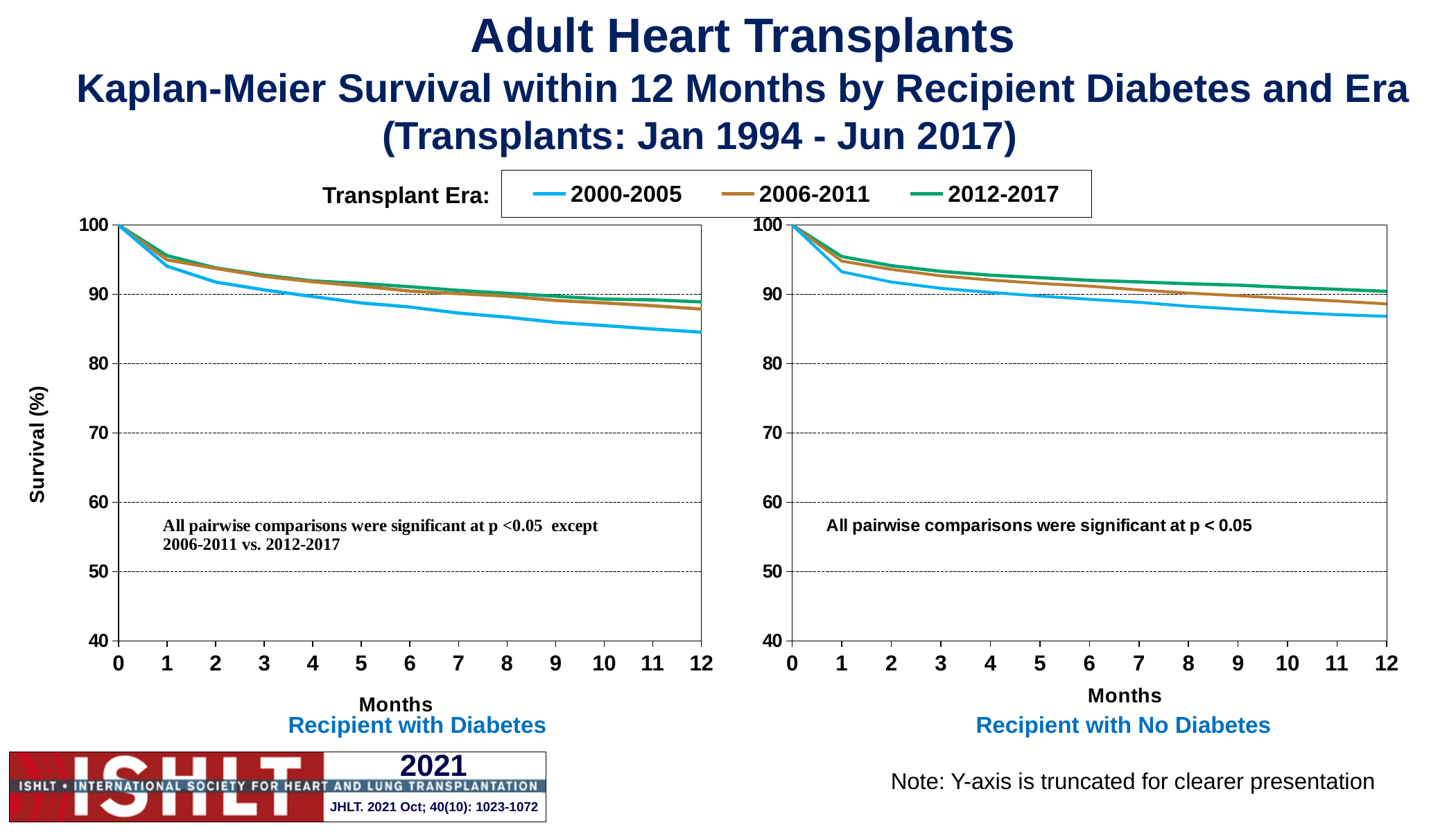
In the Recipient with Diabetes chart, is the survival for 2000-2005 at 12 months greater or less than 80? greater What type of chart is used on the slide for the Recipient with Diabetes panel? line chart What is the label of the y-axis on the slide? Survival (%) In the Recipient with Diabetes chart, is the survival for 2000-2005 at 12 months greater or less than 90? less In the Recipient with No Diabetes chart, which transplant era has the lowest survival at 12 months? 2000-2005 In the Recipient with No Diabetes chart, at 12 months is survival for 2012-2017 higher or lower than for 2000-2005? higher Which colour represents the 2012-2017 transplant era in the legend? green In the Recipient with Diabetes chart, which transplant era has the lowest survival at 12 months? 2000-2005 How many transplant eras does the legend list? 3 In the Recipient with No Diabetes chart, which transplant era has the highest survival at 12 months? 2012-2017 In the Recipient with Diabetes chart, does survival rise or fall as months increase? fall In the Recipient with No Diabetes chart, is the survival for 2000-2005 at 12 months greater or less than 90? less